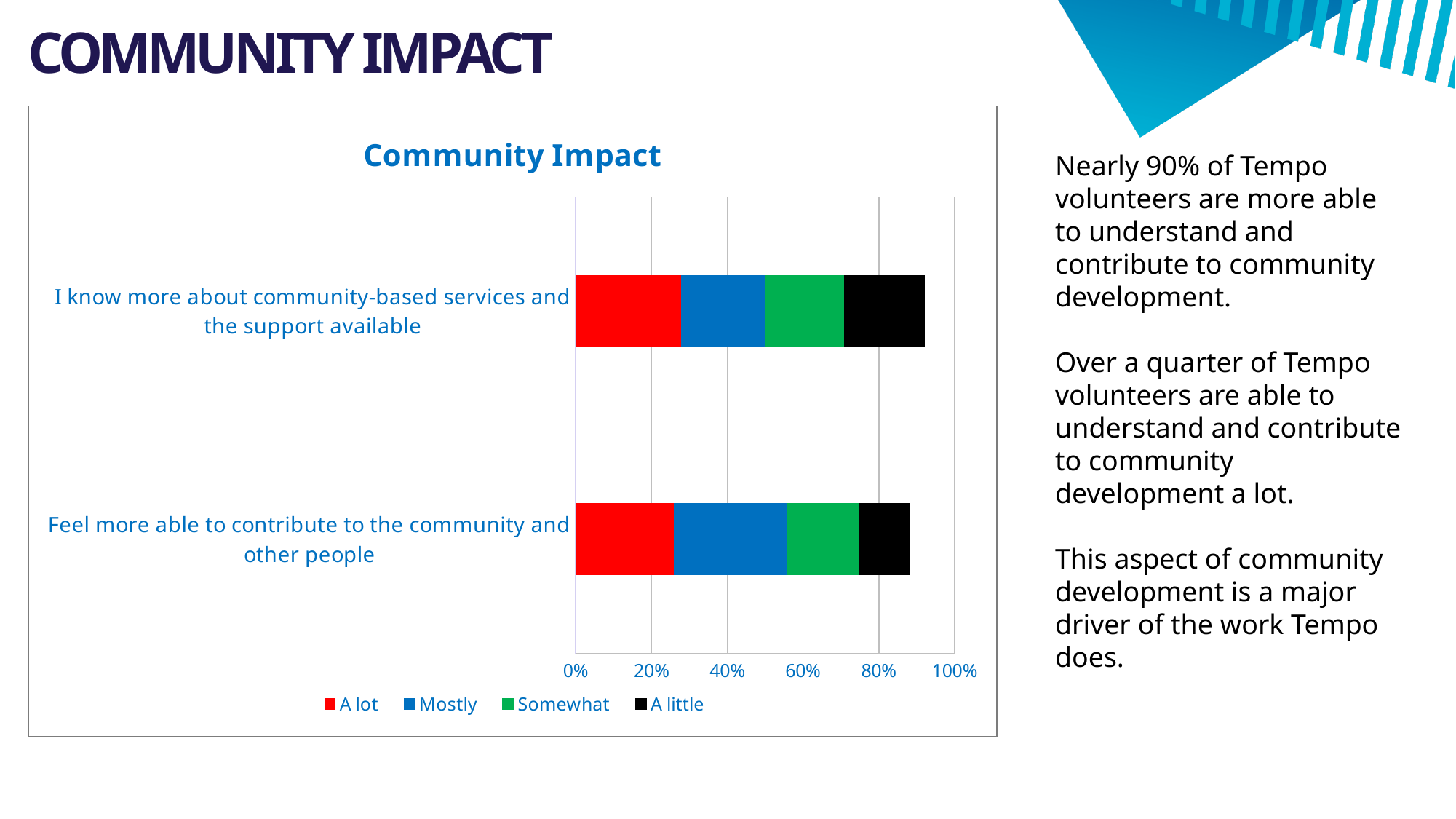
How many categories (bars) does the chart show? 2 Which colour represents the 'A lot' series in the chart? Red Is the total length of the bar for 'I know more about community-based services and the support available' greater or less than 80%? greater Is the total length of the bar for 'Feel more able to contribute to the community and other people' greater or less than 80%? greater What kind of chart is shown on the slide? Stacked bar chart Is the 'A little' segment for 'Feel more able to contribute to the community and other people' greater or less than 20%? less What is the title of the chart? Community Impact How many series does the chart legend list? 4 Which category has the larger 'Mostly' segment? Feel more able to contribute to the community and other people Which category has the larger 'A little' segment? I know more about community-based services and the support available